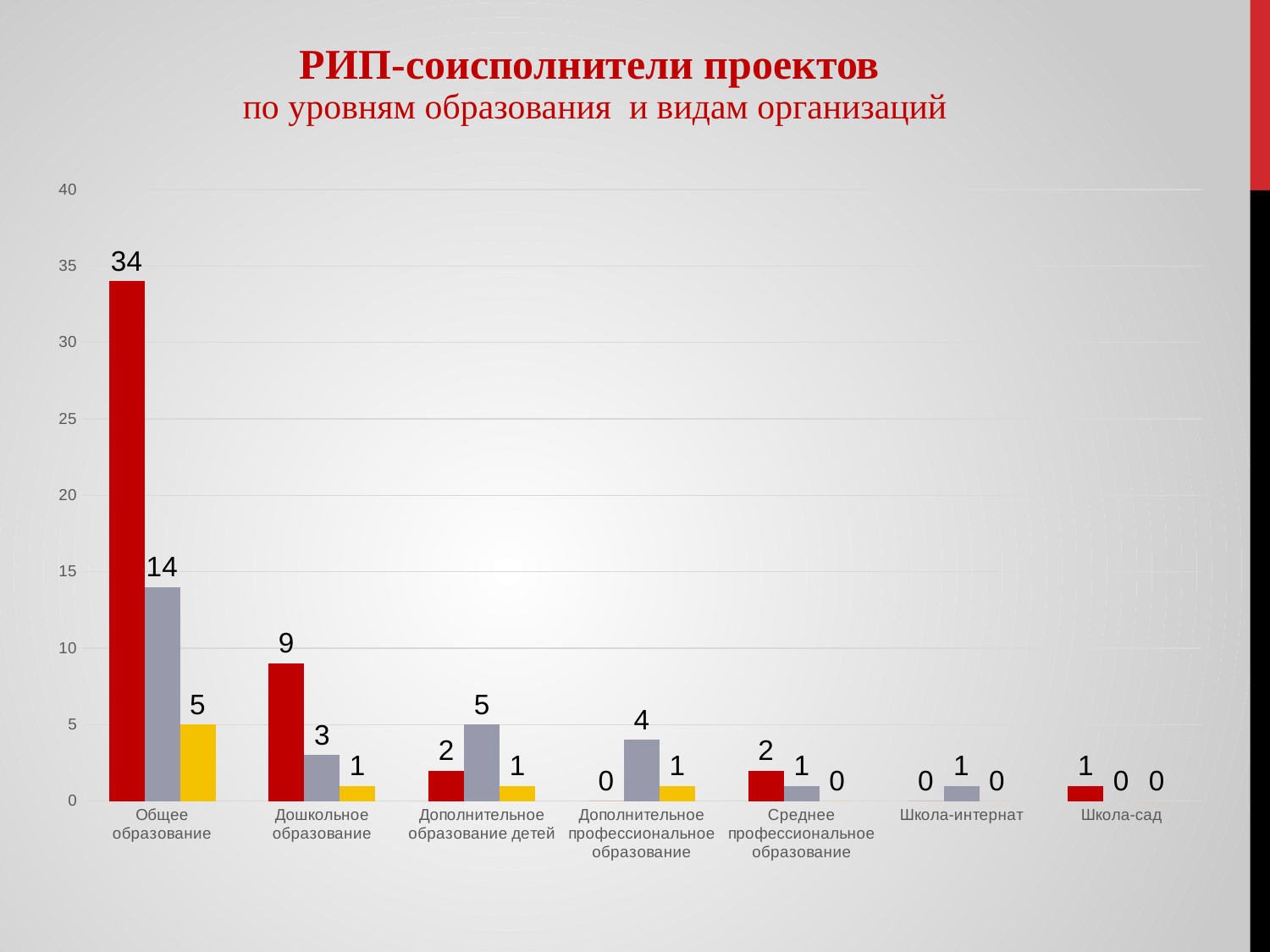
What is the value of the grey bar for Дошкольное образование? 3 What is the value of the grey bar for Дополнительное образование детей? 5 Which is larger for Дополнительное образование детей: the red bar or the grey bar? the grey bar What is the value of the red bar for Общее образование? 34 What is the total of the three bars for Дошкольное образование? 13 What is the difference between the red bar and the grey bar for Общее образование? 20 How many categories are shown on the x axis? 7 What kind of chart is shown on the slide? bar chart What is the value of the red bar for Школа-сад? 1 Which category has the highest red bar? Общее образование What is the title of the chart? РИП-соисполнители проектов по уровням образования и видам организаций What is the value of the yellow bar for Дополнительное профессиональное образование? 1